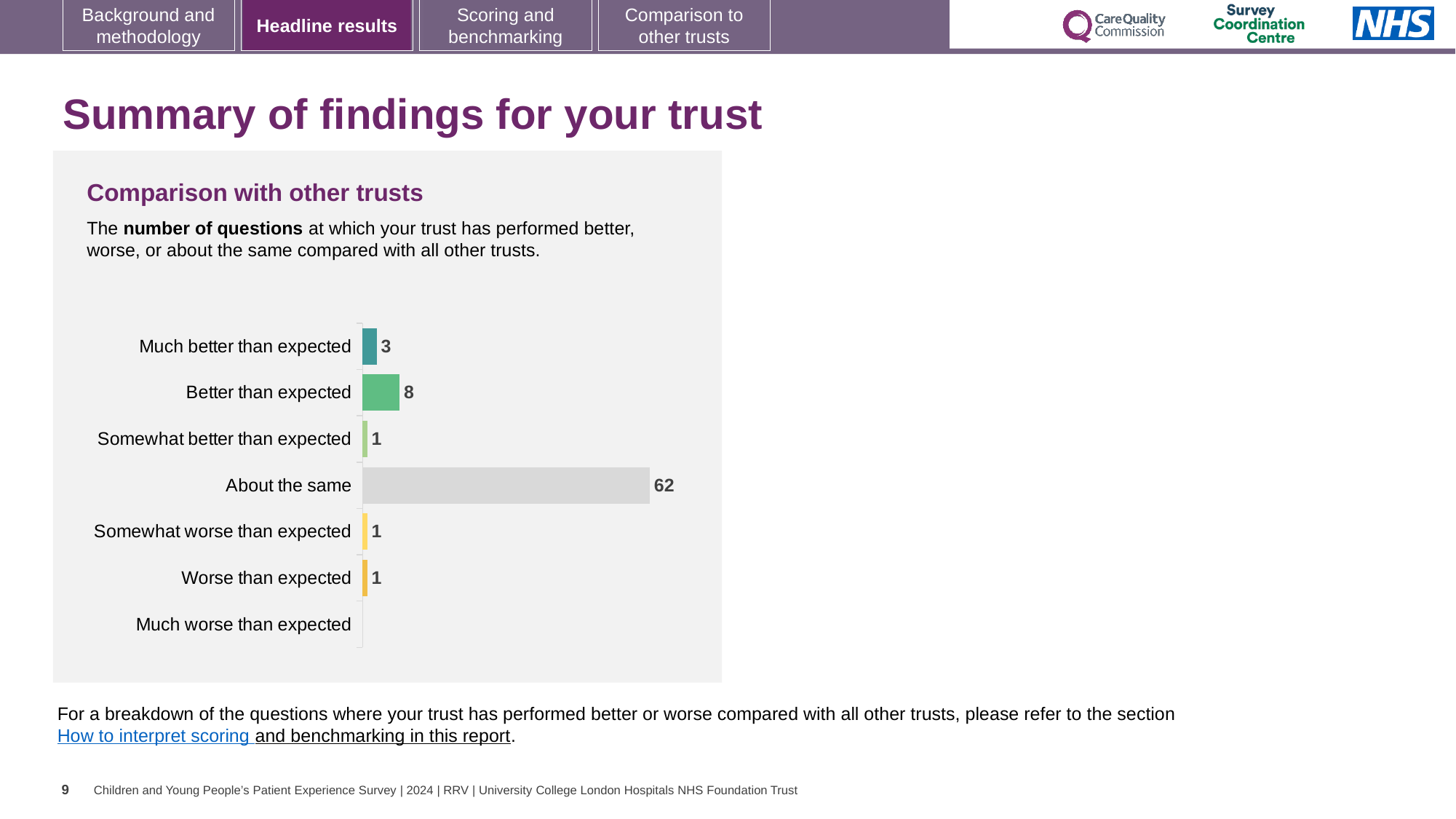
Which is larger, 'Much better than expected' or 'Somewhat better than expected'? Much better than expected What is the value for 'Much better than expected'? 3 What is the value for 'About the same'? 62 How many categories are shown on the chart? 7 What is the value for 'Better than expected'? 8 What is the difference between 'Better than expected' and 'Much better than expected'? 5 What is the title of the chart? Comparison with other trusts Which category has the highest value? About the same What is the value for 'Worse than expected'? 1 What is the difference between 'About the same' and 'Better than expected'? 54 Which category has no bar shown? Much worse than expected What kind of chart is shown? Bar chart